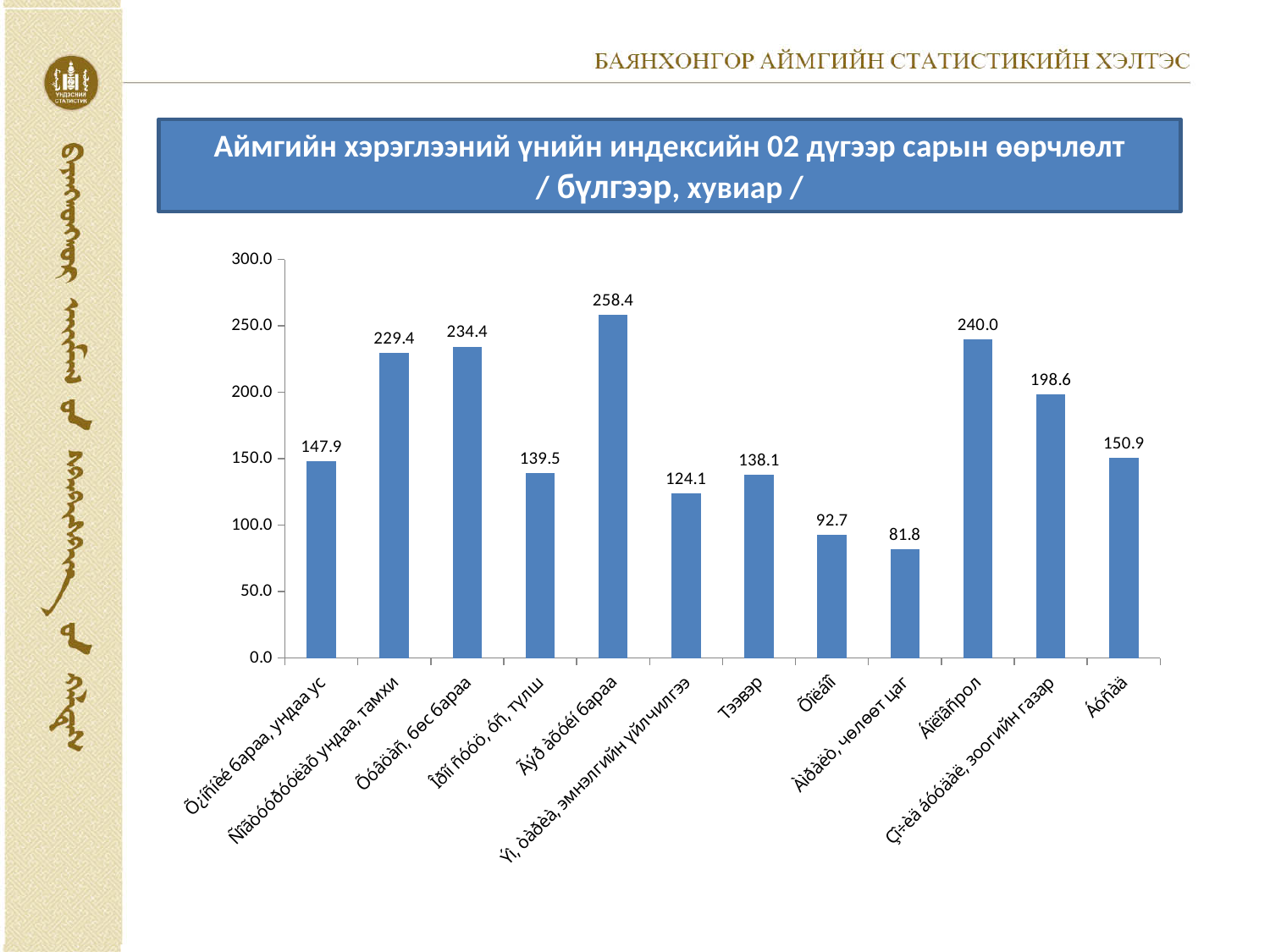
What is the value of the bar whose label ends with 'зоогийн газар'? 198.6 How many bars are plotted in the chart? 12 How many bars have a value above 200? 4 What is the highest value shown in the chart? 258.4 What is the title of the chart on the slide? Аймгийн хэрэглээний үнийн индексийн 02 дүгээр сарын өөрчлөлт / бүлгээр, хувиар / What is the value of the second bar from the left? 229.4 What is the lowest value shown in the chart? 81.8 What kind of chart is shown on the slide? bar chart Which is larger, the value of the first bar (147.9) or the value of the last bar (150.9)? the last bar (150.9) What is the value for Тээвэр? 138.1 Is the value for Тээвэр greater or less than 150? less What is the difference between the highest value (258.4) and the value for Тээвэр? 120.3